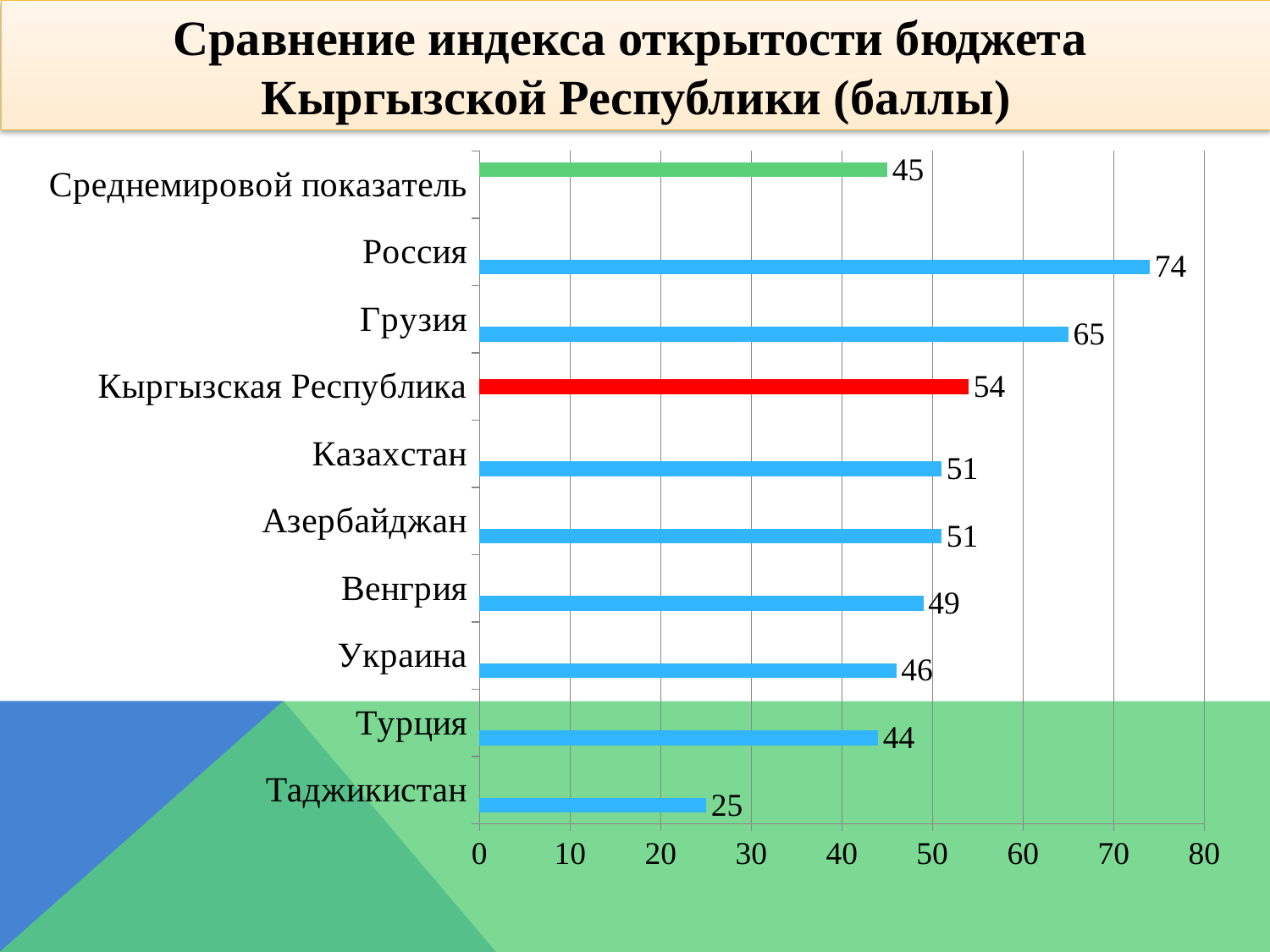
Which is larger, the value for Венгрия or the value for Украина? Венгрия Which category has the highest value? Россия What is the value for Среднемировой показатель? 45 How many categories are shown on the chart? 10 What kind of chart is shown on the slide? bar chart Which bar is coloured red? Кыргызская Республика What is the value for Таджикистан? 25 What is the value for Кыргызская Республика? 54 Which category has the lowest value? Таджикистан What is the difference between the values for Кыргызская Республика and Среднемировой показатель? 9 Is the value for Турция greater or less than 50? less What is the difference between the values for Россия and Грузия? 9